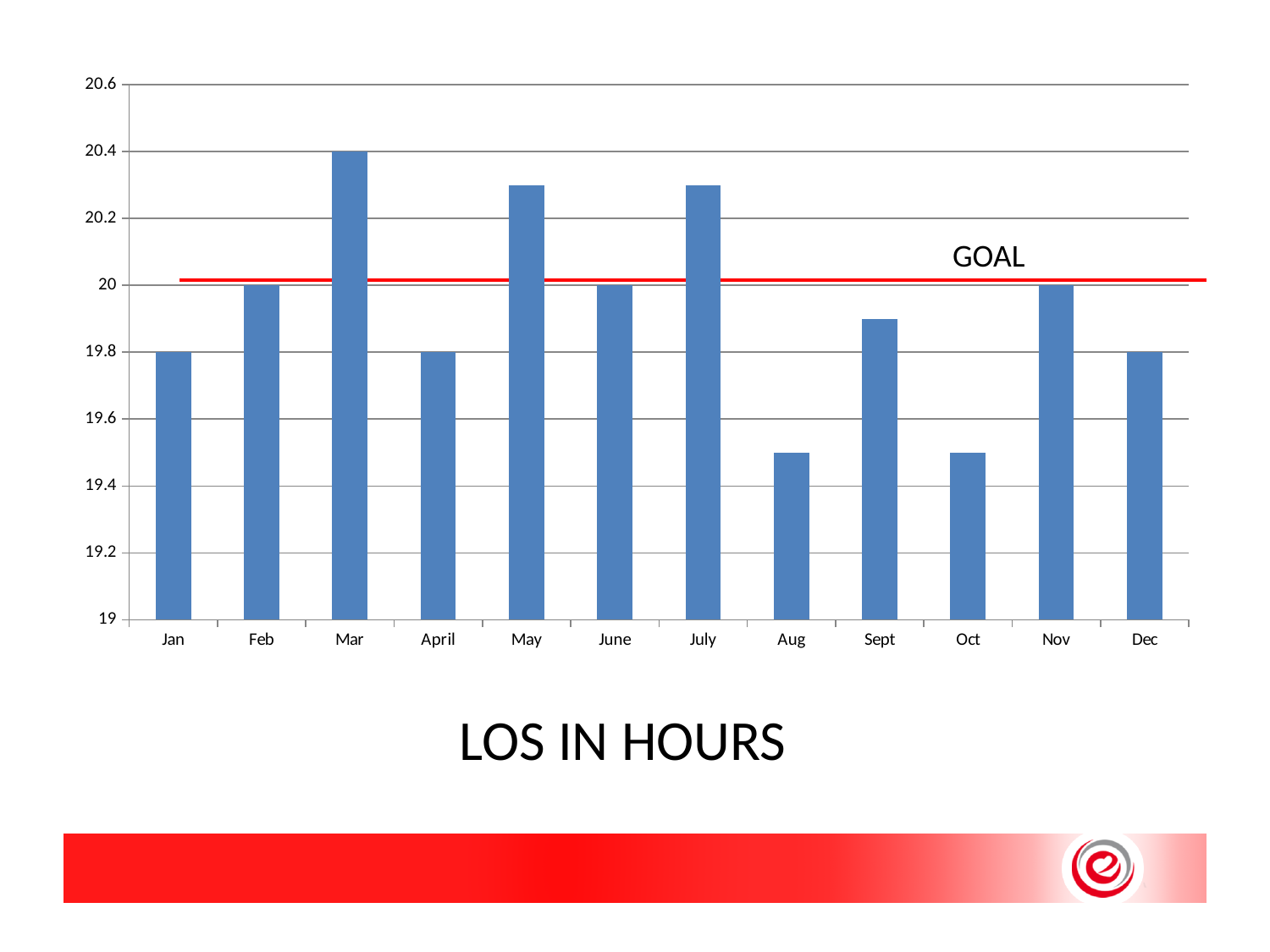
What type of chart is shown on the slide? bar chart Is the value for May greater or less than 20.2? greater What is the value for Feb? 20 Which month has the highest value? Mar What is the title shown below the chart? LOS IN HOURS Which is larger, the value for May or the value for Aug? May What is the value for Mar? 20.4 How many months are plotted on the x axis? 12 What is the value for Jan? 19.8 What label is given to the red horizontal line on the chart? GOAL Is the value for Oct greater or less than 19.6? less What is the difference between the values for Mar and Jan? 0.6